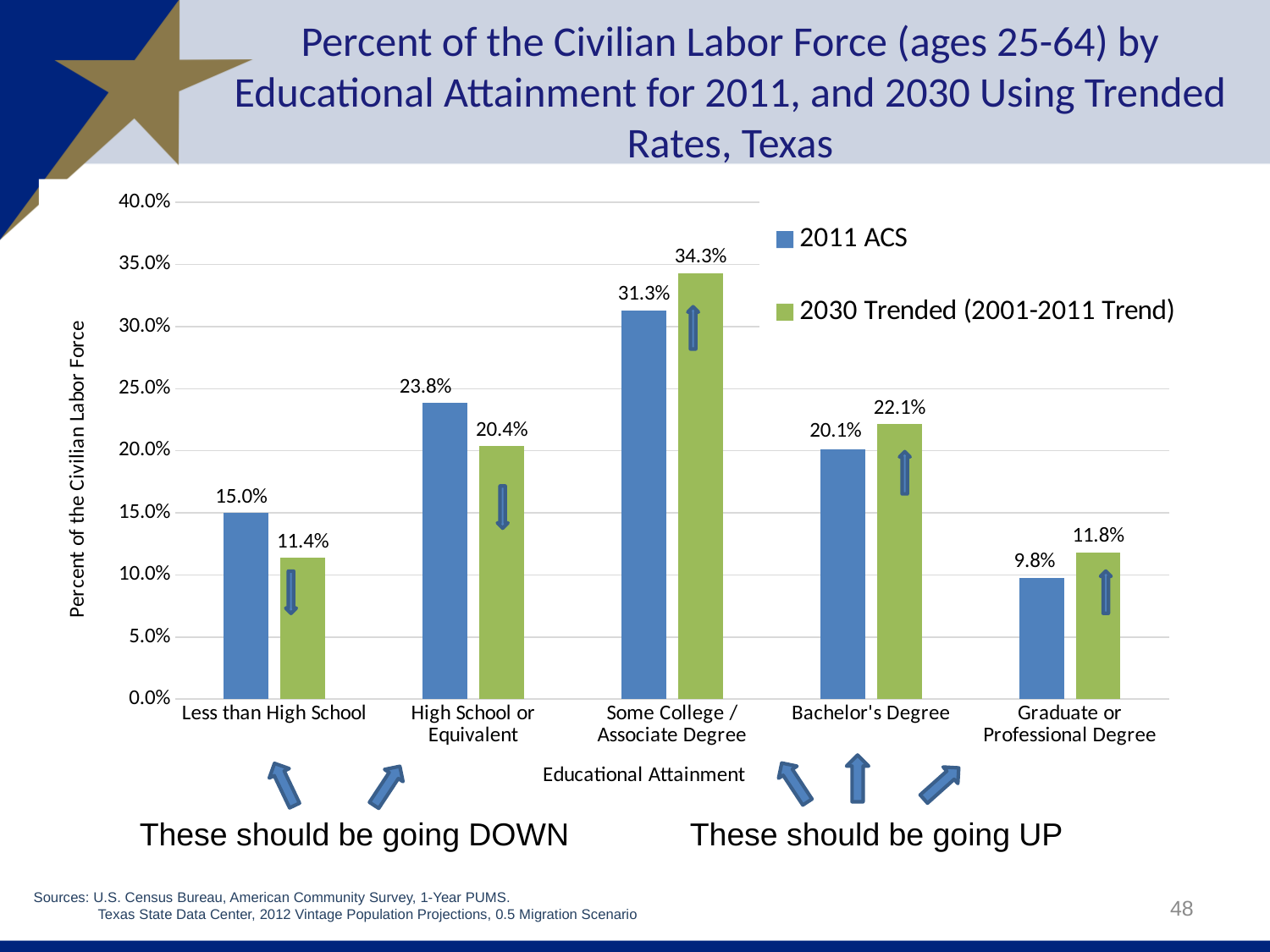
What is the 2011 ACS value for Graduate or Professional Degree? 9.8% What is the 2030 Trended (2001-2011 Trend) value for Less than High School? 11.4% What is the difference between the 2011 ACS and 2030 Trended values for High School or Equivalent? 3.4% How many educational attainment categories are shown on the x axis? 5 For Bachelor's Degree, which is larger: the 2011 ACS value or the 2030 Trended value? 2030 Trended (2001-2011 Trend) Is the 2011 ACS value for High School or Equivalent greater or less than 20.0%? greater What is the 2011 ACS value for Some College / Associate Degree? 31.3% Which educational attainment category has the lowest 2011 ACS value? Graduate or Professional Degree Which educational attainment category has the highest 2030 Trended value? Some College / Associate Degree What kind of chart is shown on the slide? bar chart How many series does the legend list? 2 What is the label of the y axis? Percent of the Civilian Labor Force